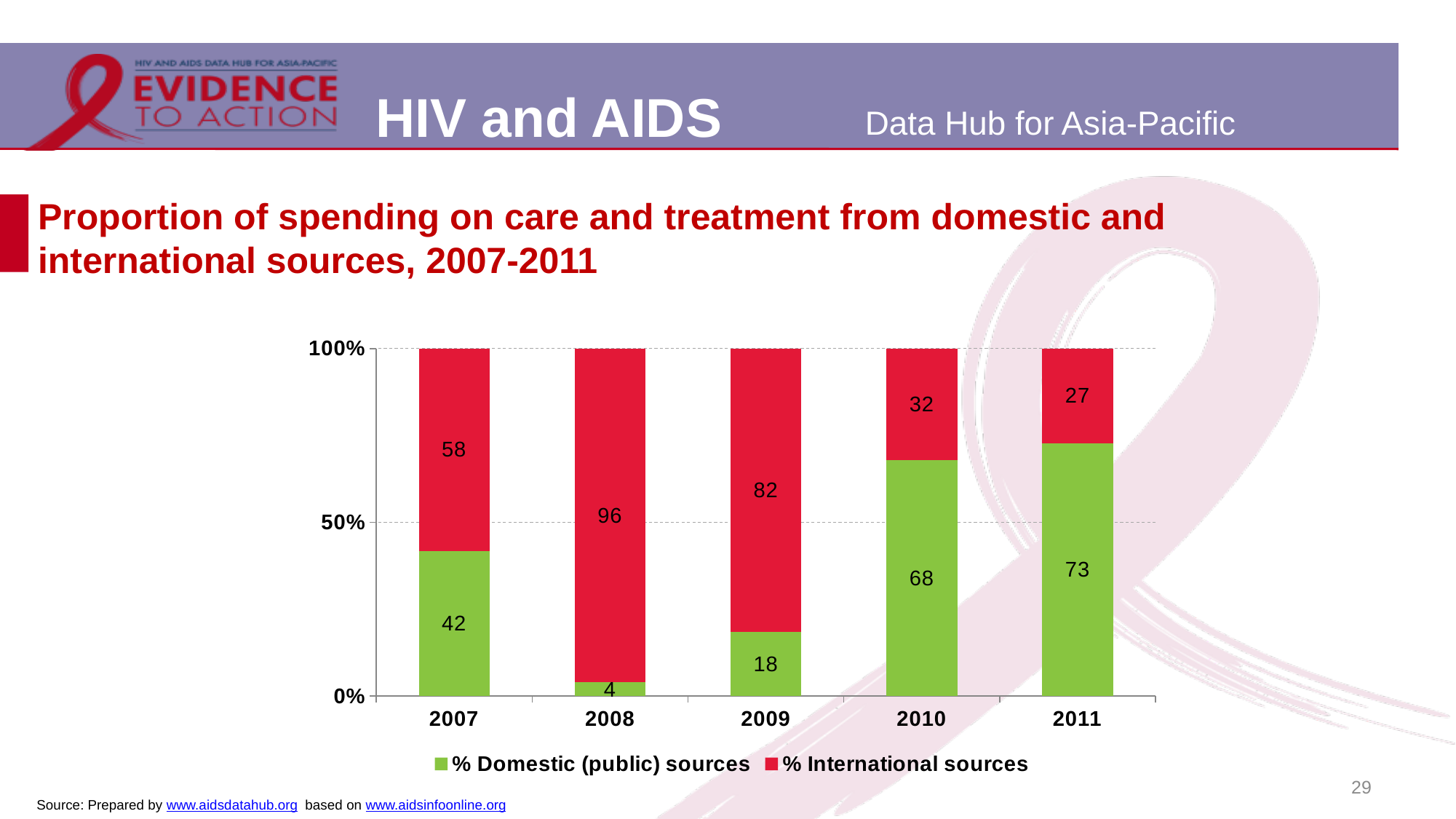
What kind of chart is shown on the slide? Stacked bar chart Does the value for % Domestic (public) sources rise or fall from 2008 to 2011? Rise Which is larger in 2009: % Domestic (public) sources or % International sources? % International sources What is the value for % Domestic (public) sources in 2011? 73 How many years are shown on the x axis? 5 What is the value for % International sources in 2008? 96 What is the value for % Domestic (public) sources in 2007? 42 Which year has the highest value for % International sources? 2008 What is the difference between the % Domestic (public) sources values for 2011 and 2010? 5 Which year has the lowest value for % Domestic (public) sources? 2008 Which colour represents % International sources in the chart? Red How many series does the legend list? 2